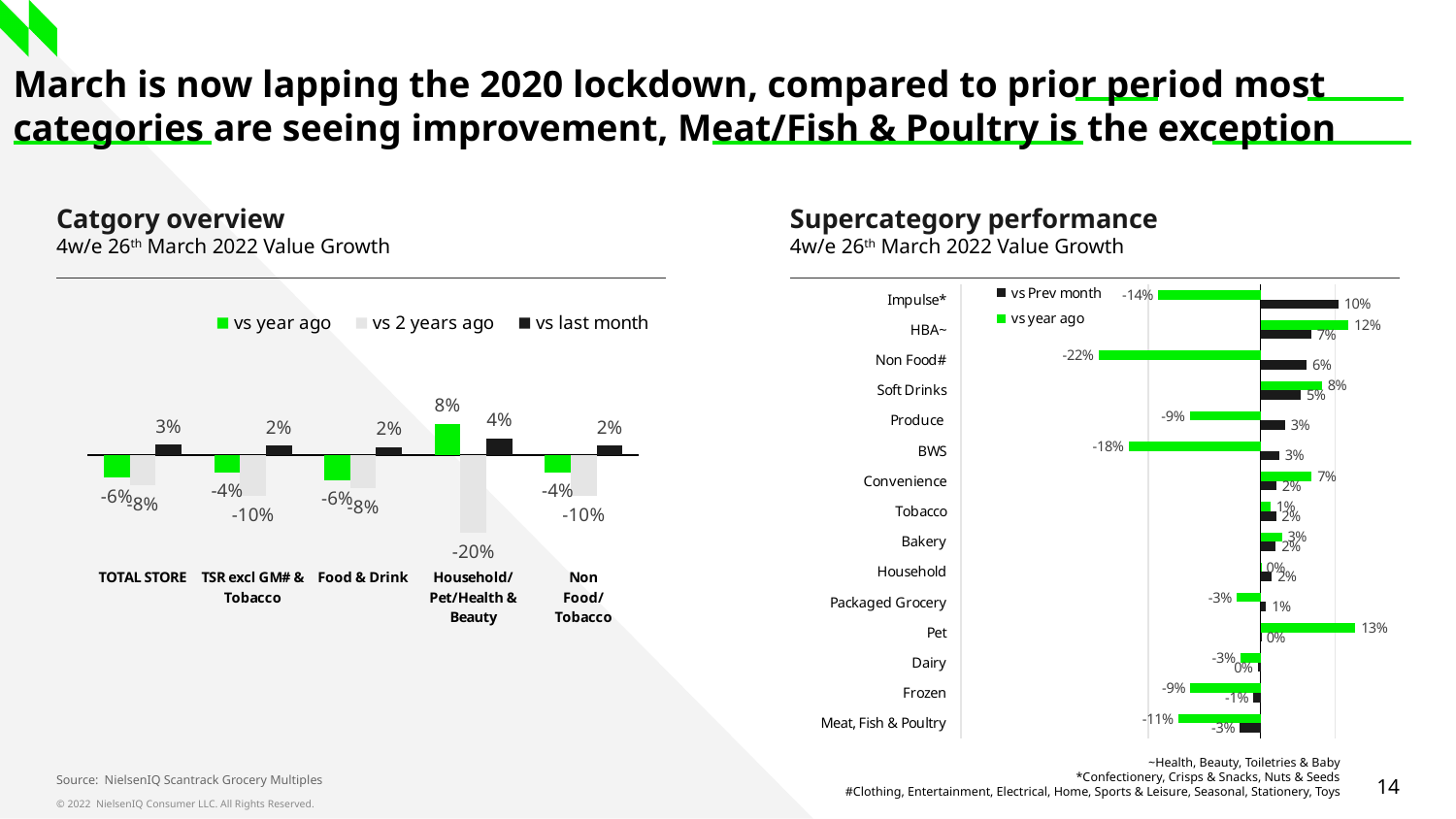
In the Catgory overview chart, what is the vs last month value for TOTAL STORE? 3% In the Supercategory performance chart, what is the vs Prev month value for Meat, Fish & Poultry? -3% In the Catgory overview chart, what is the vs 2 years ago value for Household/Pet/Health & Beauty? -20% In the Supercategory performance chart, what is the vs year ago value for Non Food#? -22% In the Supercategory performance chart, which category has the highest vs year ago value? Pet In the Supercategory performance chart, how many categories are plotted? 15 In the Catgory overview chart, which category has the highest vs year ago value? Household/Pet/Health & Beauty In the Supercategory performance chart, which category has the lowest vs Prev month value? Meat, Fish & Poultry In the Supercategory performance chart, which is larger: the vs Prev month value for Impulse* or for HBA~? Impulse* In the Catgory overview chart, how many series does the legend list? 3 In the Catgory overview chart, what is the difference between the vs year ago and vs 2 years ago values for TSR excl GM# & Tobacco? 6 percentage points What type of chart is the Supercategory performance chart? Bar chart